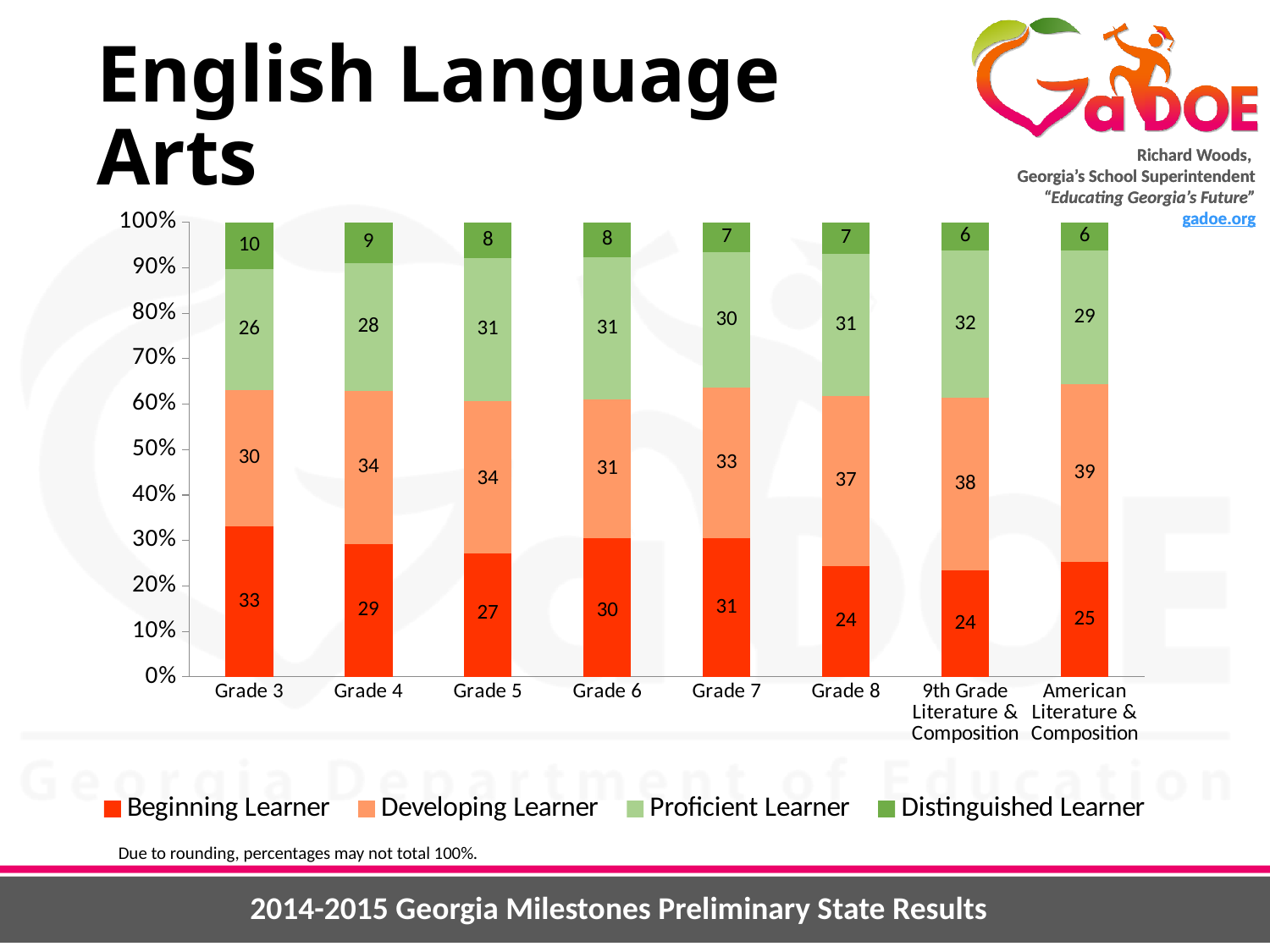
Does the Distinguished Learner value rise or fall from Grade 3 to American Literature & Composition? fall What is the Proficient Learner value for 9th Grade Literature & Composition? 32 Which is larger, the Developing Learner value for Grade 4 or for Grade 8? Grade 8 Which category has the highest Distinguished Learner value? Grade 3 What percentage of Grade 3 students are Beginning Learners? 33 Which category has the highest Developing Learner value? American Literature & Composition How many series does the legend list? 4 Which category has the highest Beginning Learner value? Grade 3 What is the Distinguished Learner value for Grade 7? 7 How many categories are shown on the x axis? 8 What is the difference between the Beginning Learner values for Grade 3 and Grade 8? 9 What is the Developing Learner value for American Literature & Composition? 39